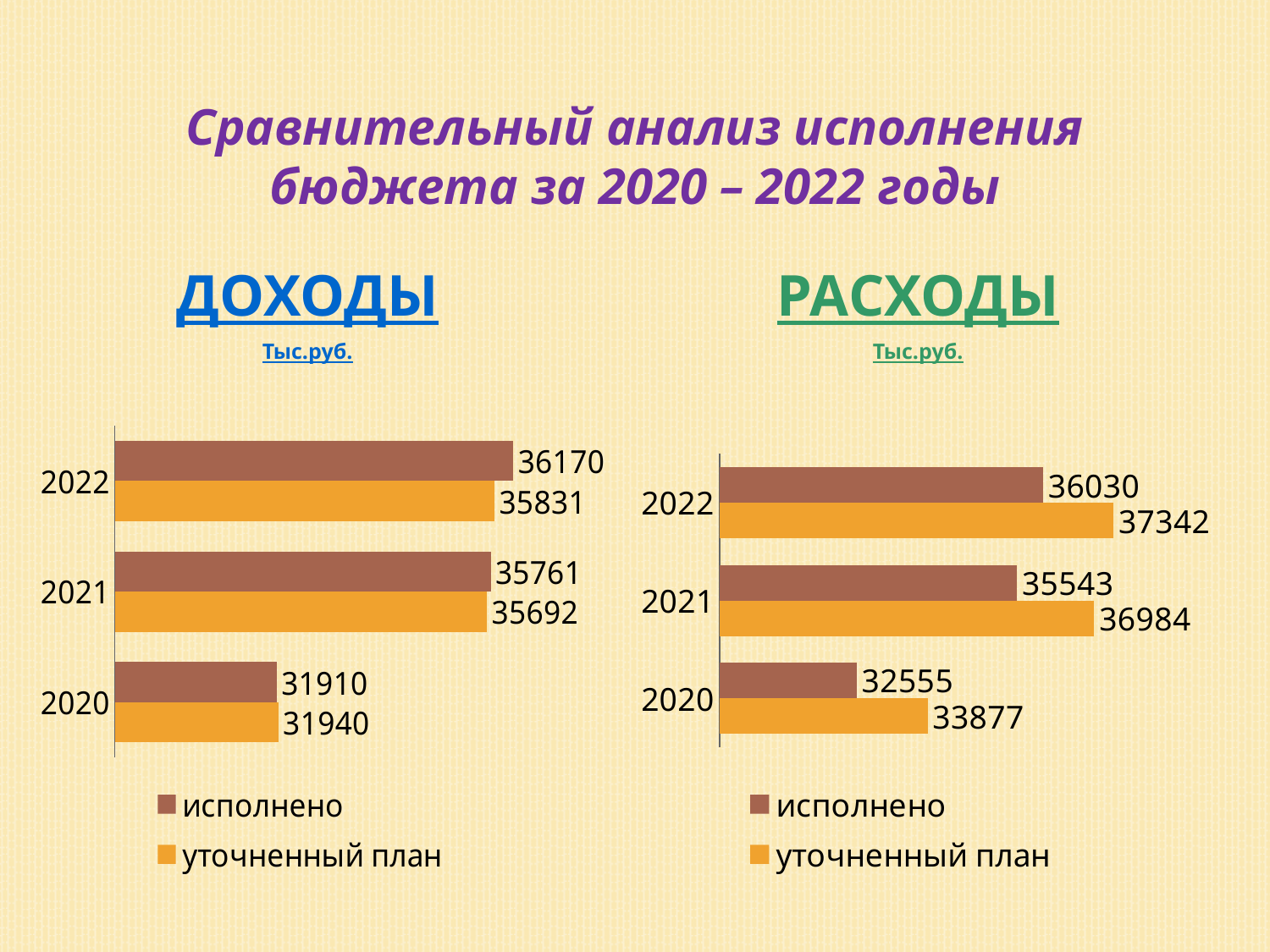
In the РАСХОДЫ chart, what is the difference between уточненный план and исполнено for 2022? 1312 How many series does the legend of the ДОХОДЫ chart list? 2 In the РАСХОДЫ chart, which year has the lowest уточненный план value? 2020 In the ДОХОДЫ chart, which year has the highest исполнено value? 2022 What type of chart is the ДОХОДЫ chart? bar chart How many years are shown in the РАСХОДЫ chart? 3 In the РАСХОДЫ chart, which is larger for 2020: исполнено or уточненный план? уточненный план In the ДОХОДЫ chart, what is the уточненный план value for 2020? 31940 In the РАСХОДЫ chart, what is the уточненный план value for 2022? 37342 In the РАСХОДЫ chart, what is the исполнено value for 2021? 35543 In the ДОХОДЫ chart, what is the исполнено value for 2022? 36170 In the ДОХОДЫ chart, what is the difference between исполнено and уточненный план for 2021? 69